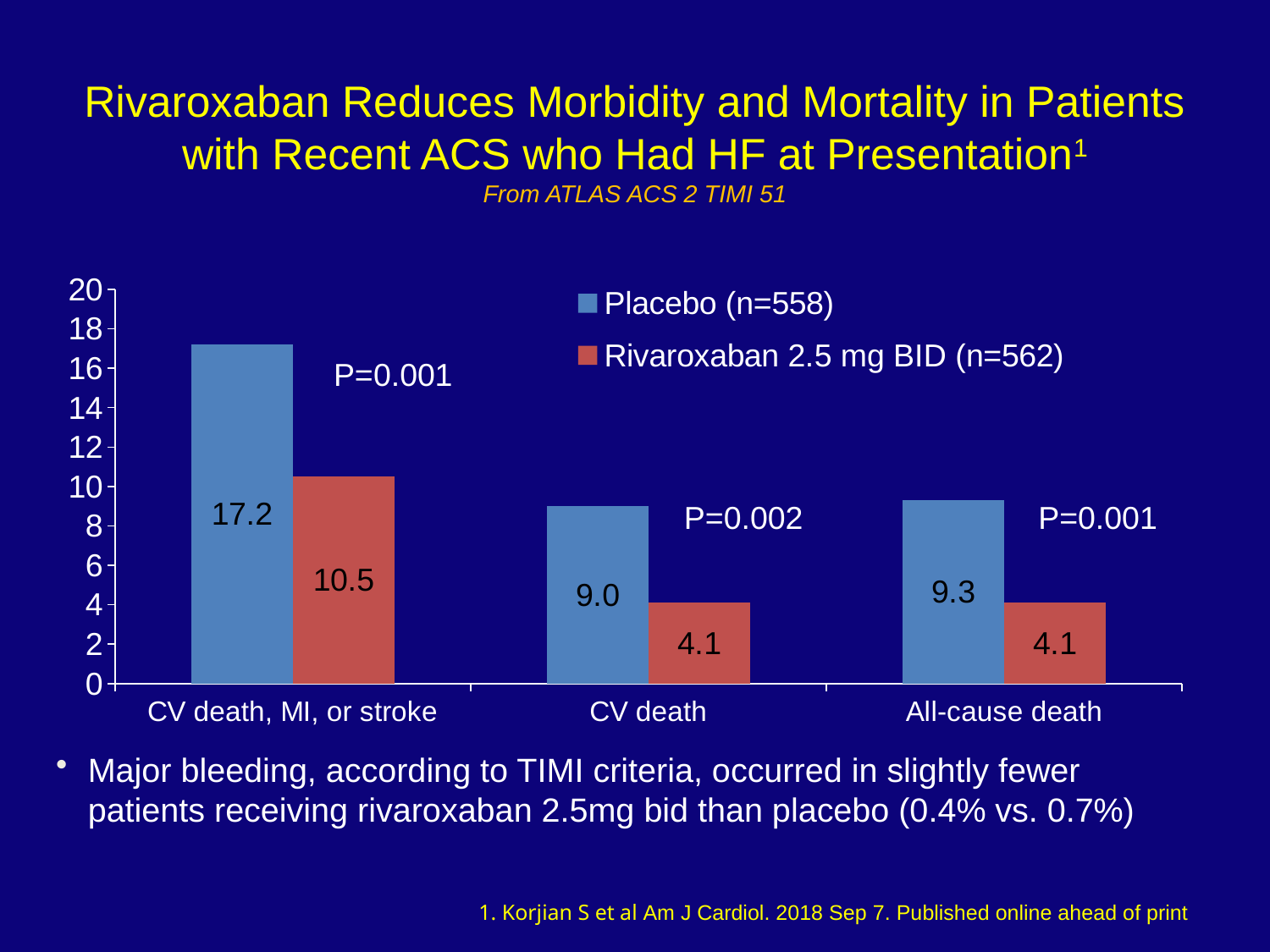
What is the difference between the Placebo and Rivaroxaban 2.5 mg BID values in the CV death, MI, or stroke category? 6.7 What kind of chart is shown on the slide? Bar chart What is the value for Placebo in the CV death, MI, or stroke category? 17.2 What is the value for Placebo in the All-cause death category? 9.3 Which is larger in the All-cause death category, the Placebo value or the Rivaroxaban 2.5 mg BID value? Placebo Which category has the lowest Placebo value? CV death How many categories are shown on the x axis? 3 Which category has the highest Placebo value? CV death, MI, or stroke How many series does the legend list? 2 What P value is shown for the CV death category? P=0.002 What is the sample size (n) shown in the legend for the Placebo group? 558 What is the value for Rivaroxaban 2.5 mg BID in the CV death category? 4.1